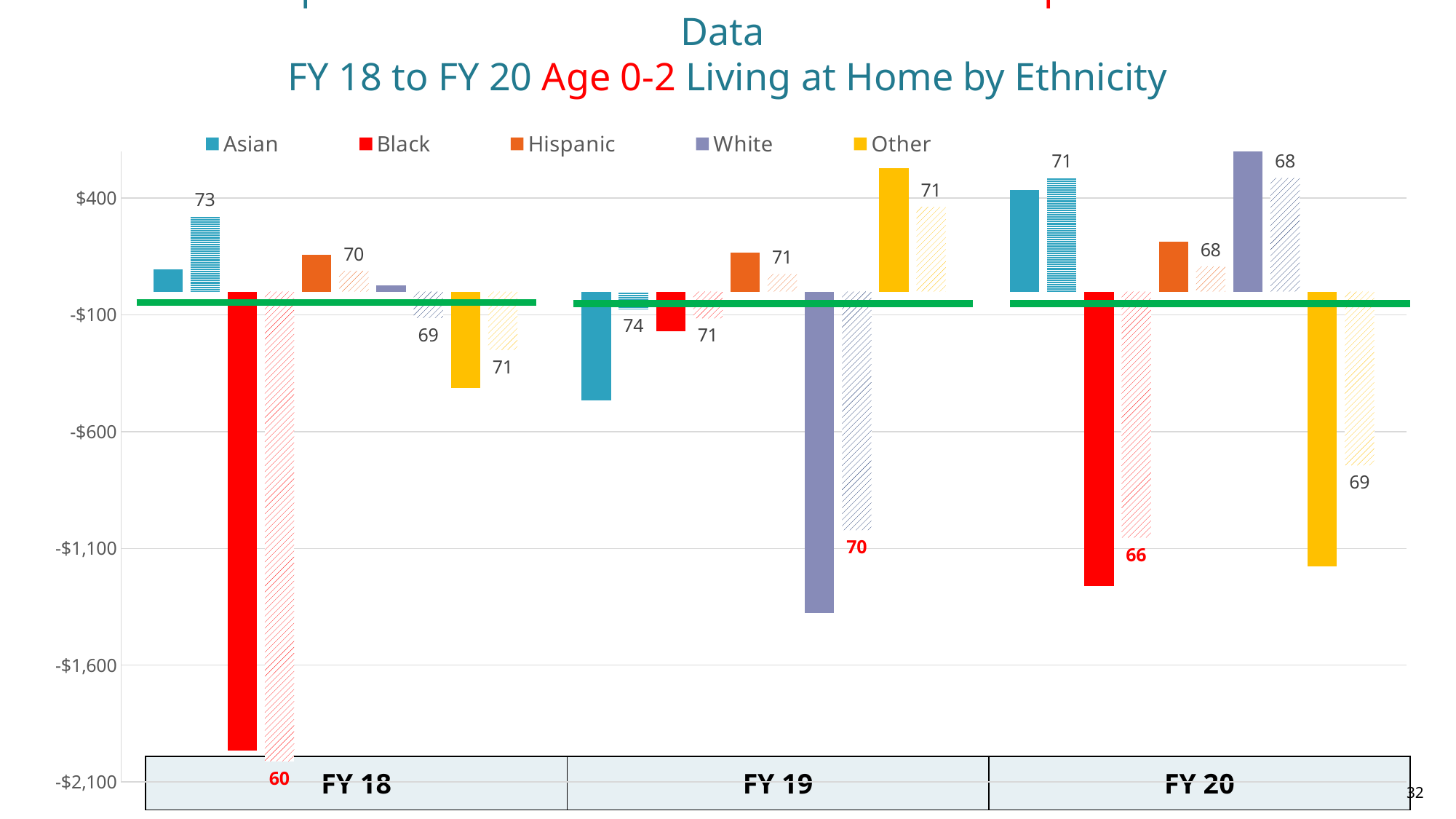
Is the value for White in FY 19 greater or less than -$1,100? less What kind of chart is shown on the slide? bar chart How many series does the legend list? 5 Which series has the lowest bar in FY 19? White What colour represents the Black series in the legend? red How many fiscal year groups are shown on the x axis? 3 Which series has the lowest bar in FY 20? Black Is the value for Black in FY 18 greater or less than -$1,600? less Is the value for Other in FY 19 greater or less than $400? greater Which series has the lowest bar in FY 18? Black Which is lower, the Black bar in FY 18 or the White bar in FY 19? Black bar in FY 18 What number is printed next to the Black bars in FY 18? 60